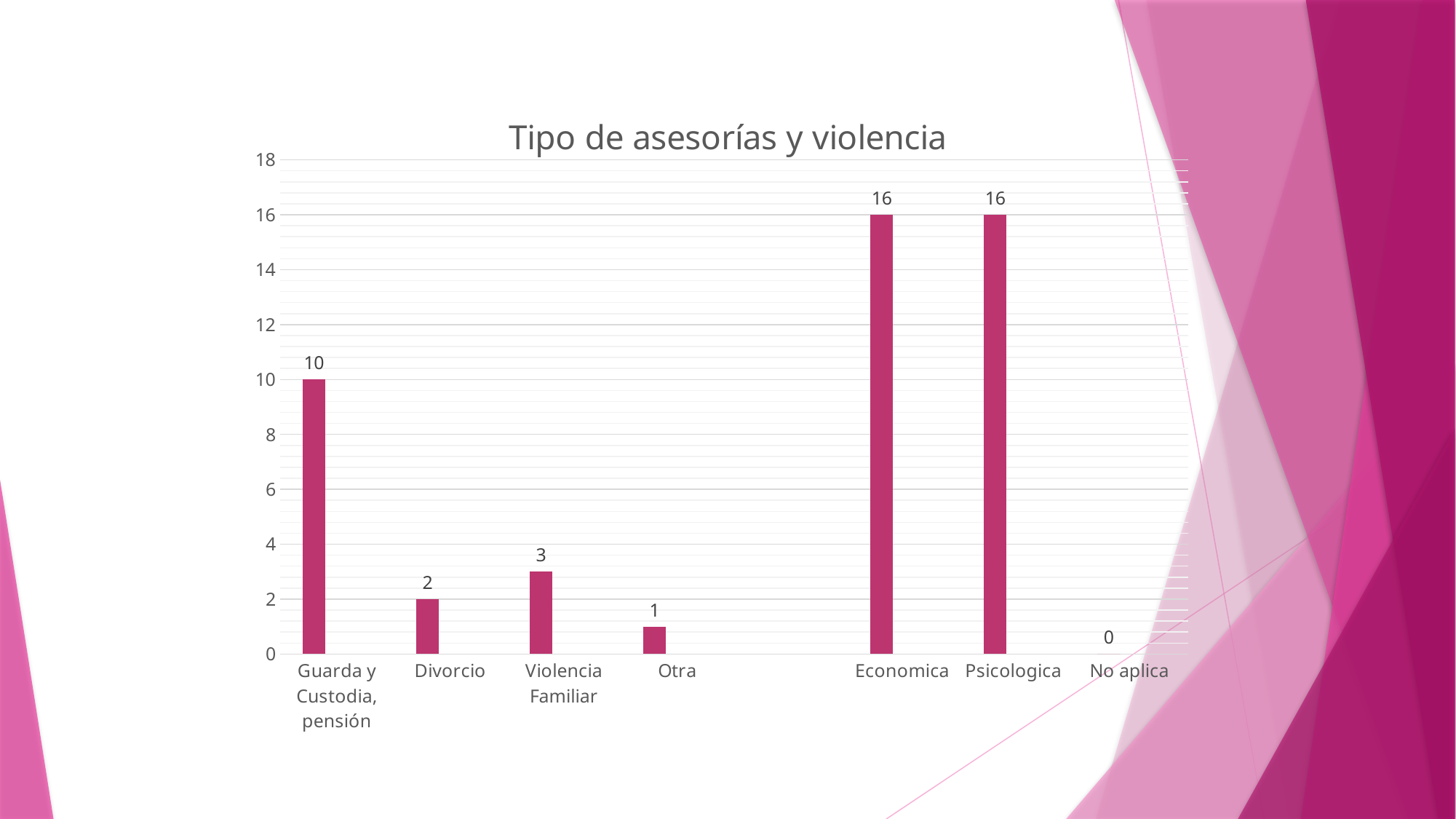
Which is larger, the value for Violencia Familiar or the value for Divorcio? Violencia Familiar What kind of chart is shown on the slide? Bar chart What is the difference between the values for Economica and Guarda y Custodia, pensión? 6 What is the value for Violencia Familiar? 3 Is the value for Psicologica greater or less than 14? greater What is the value for Otra? 1 What is the title of the chart? Tipo de asesorías y violencia Which category has the lowest value? No aplica What is the value for Guarda y Custodia, pensión? 10 What is the value for Economica? 16 What is the value for Divorcio? 2 What is the value for No aplica? 0